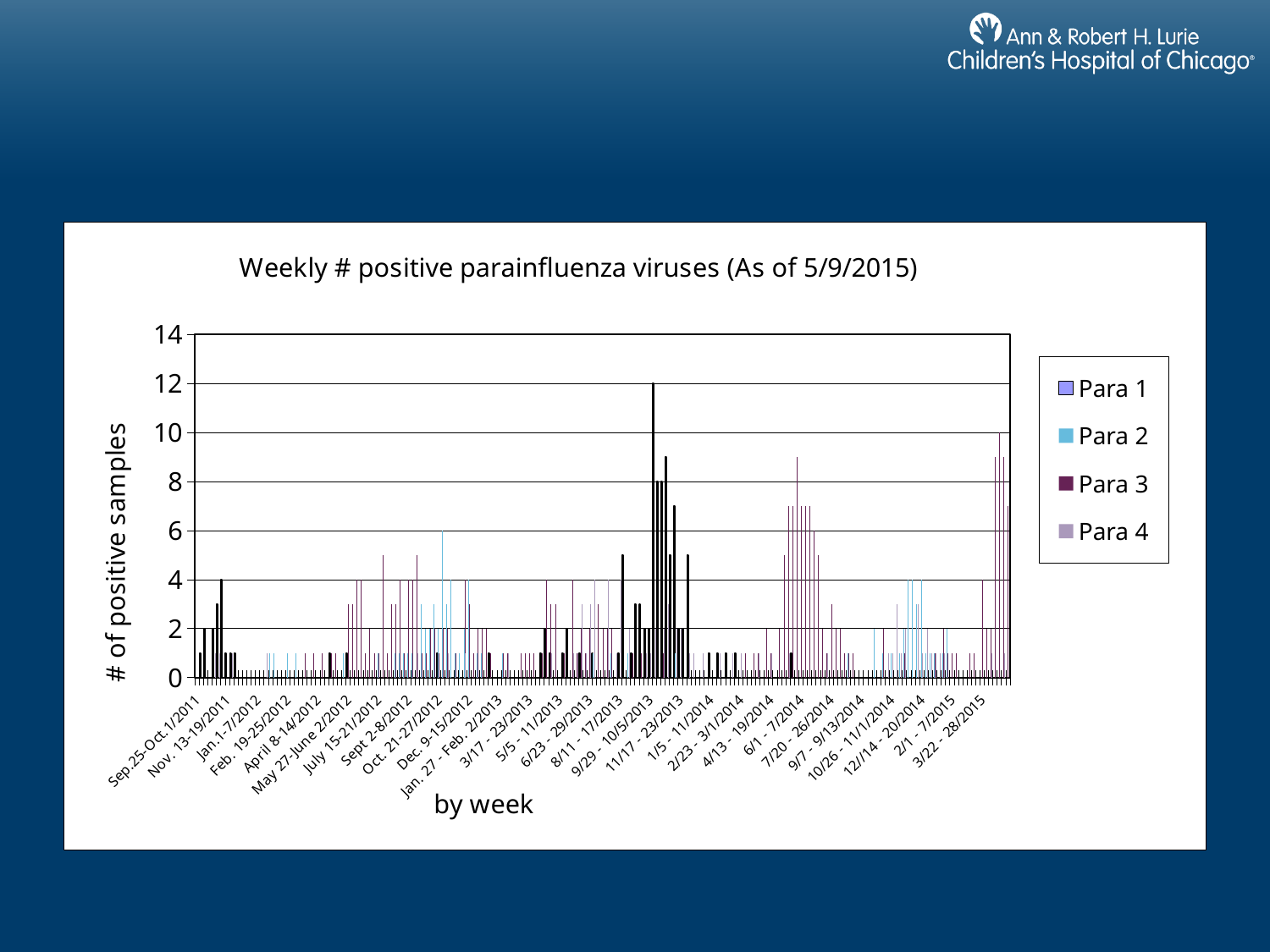
What is the title of the chart? Weekly # positive parainfluenza viruses (As of 5/9/2015) Is the tallest Para 2 bar greater or less than 8? less Is the tallest Para 4 bar greater or less than 8? less How many series does the legend list? 4 What kind of chart is shown on the slide? bar chart Which series reaches a higher peak value, Para 3 or Para 2? Para 3 Is the tallest Para 1 bar greater or less than 6? greater What is the label on the vertical axis of the chart? # of positive samples Which series has the tallest bar in the chart? Para 1